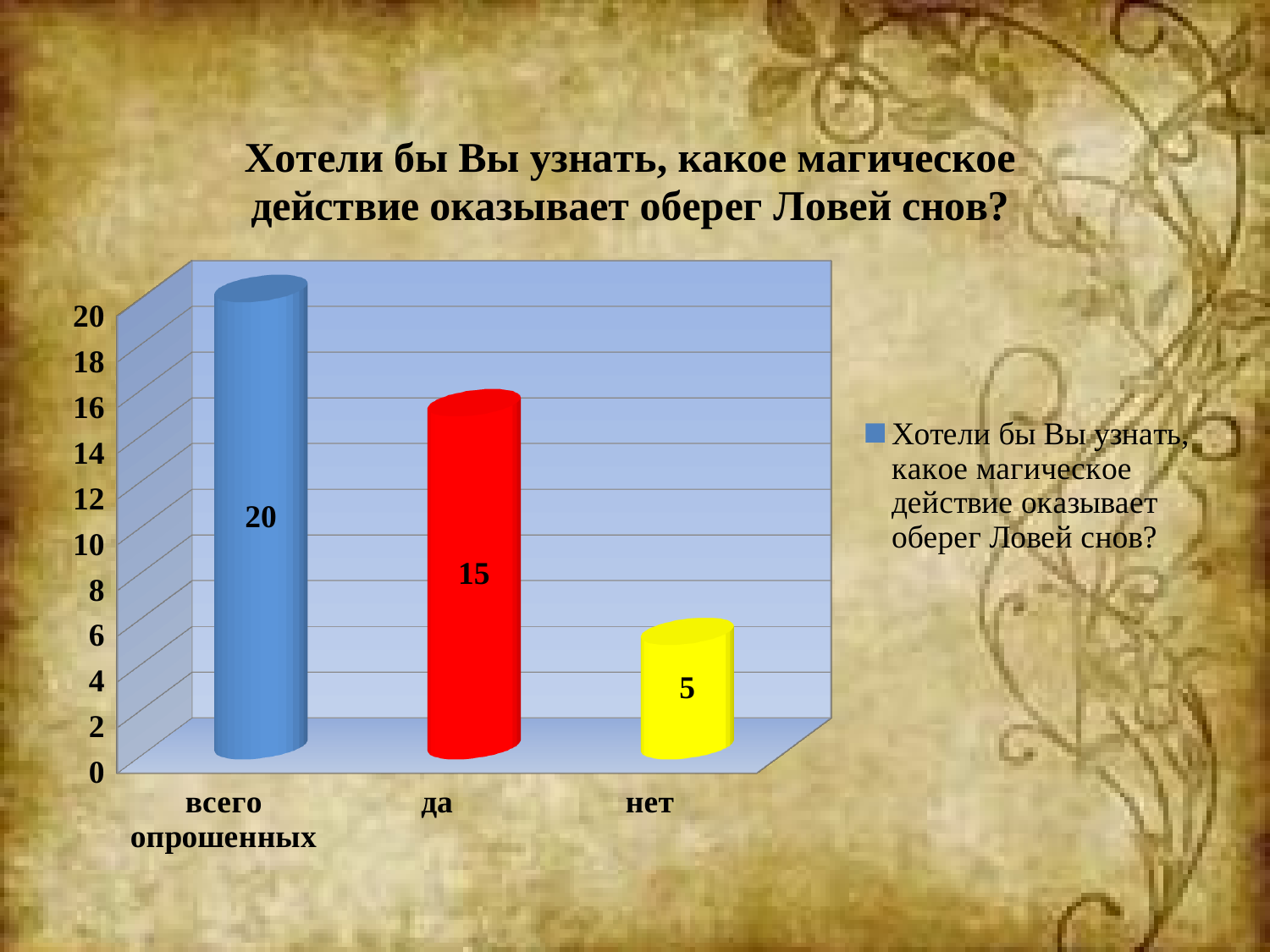
How many series does the legend list? 1 What is the value for "да"? 15 How many categories are shown on the x axis? 3 Which category has the lowest value? нет What is the difference between the values for "всего опрошенных" and "да"? 5 What is the value for "нет"? 5 What is the value for "всего опрошенных"? 20 What is the difference between the values for "да" and "нет"? 10 Which is larger, the value for "да" or the value for "нет"? да What kind of chart is shown on the slide? bar chart Which category has the highest value? всего опрошенных What colour is the bar for "нет"? yellow